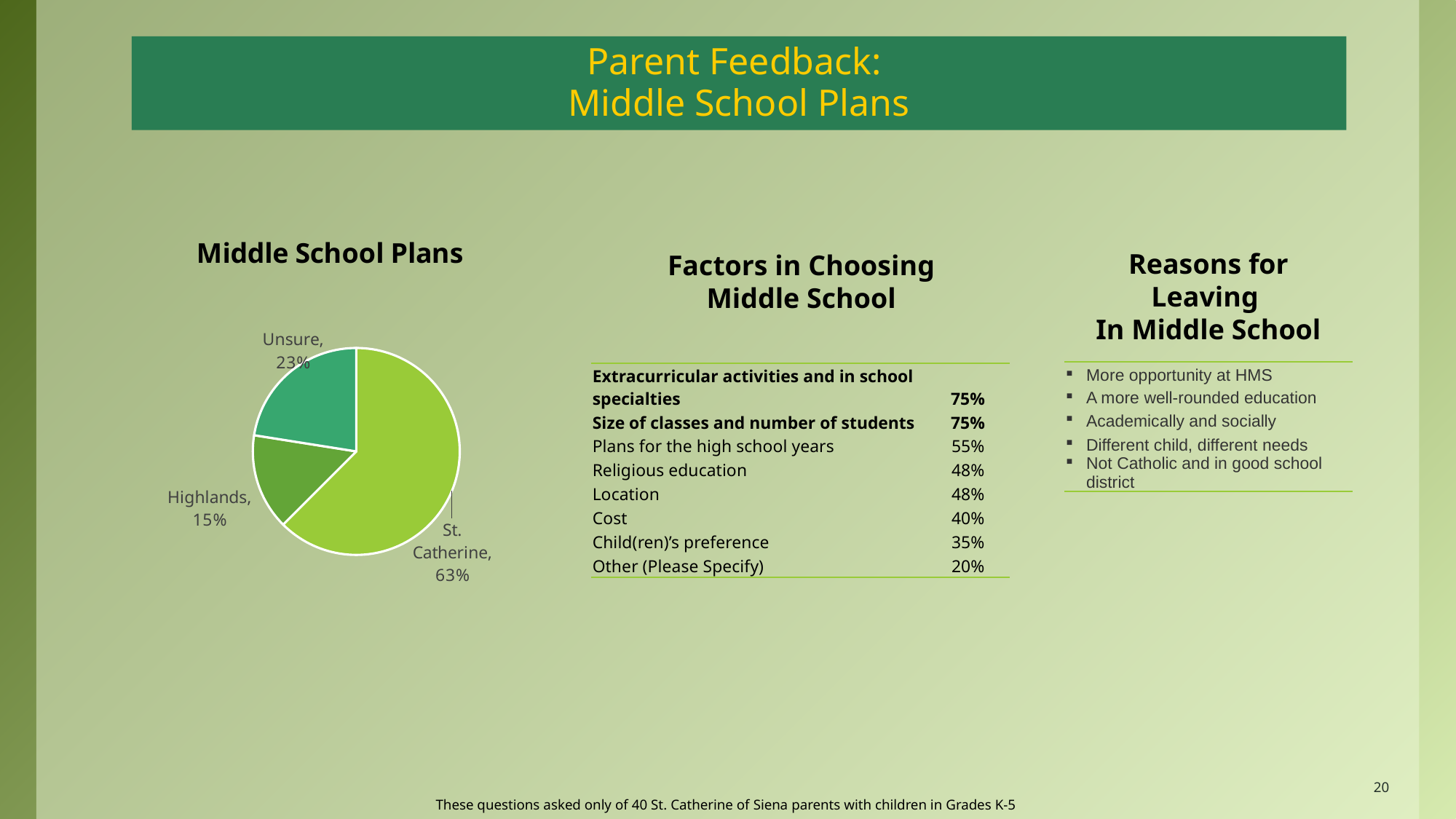
In the "Middle School Plans" pie chart, is the St. Catherine slice more or less than half of the pie? more In the "Middle School Plans" pie chart, how many percentage points larger is the Unsure slice than the Highlands slice? 8 Which slice of the "Middle School Plans" pie chart is the largest? St. Catherine In the "Middle School Plans" pie chart, what share is labelled for Highlands? 15% In the "Middle School Plans" pie chart, which is larger: the Unsure slice or the Highlands slice? Unsure How many slices does the "Middle School Plans" pie chart have? 3 Which slice of the "Middle School Plans" pie chart is the smallest? Highlands In the "Middle School Plans" pie chart, what share is labelled for St. Catherine? 63% What kind of chart is the "Middle School Plans" chart? pie chart In the "Middle School Plans" pie chart, how many percentage points larger is the St. Catherine slice than the Unsure slice? 40 In the "Middle School Plans" pie chart, what share is labelled for Unsure? 23% What is the title of the pie chart on the slide? Middle School Plans